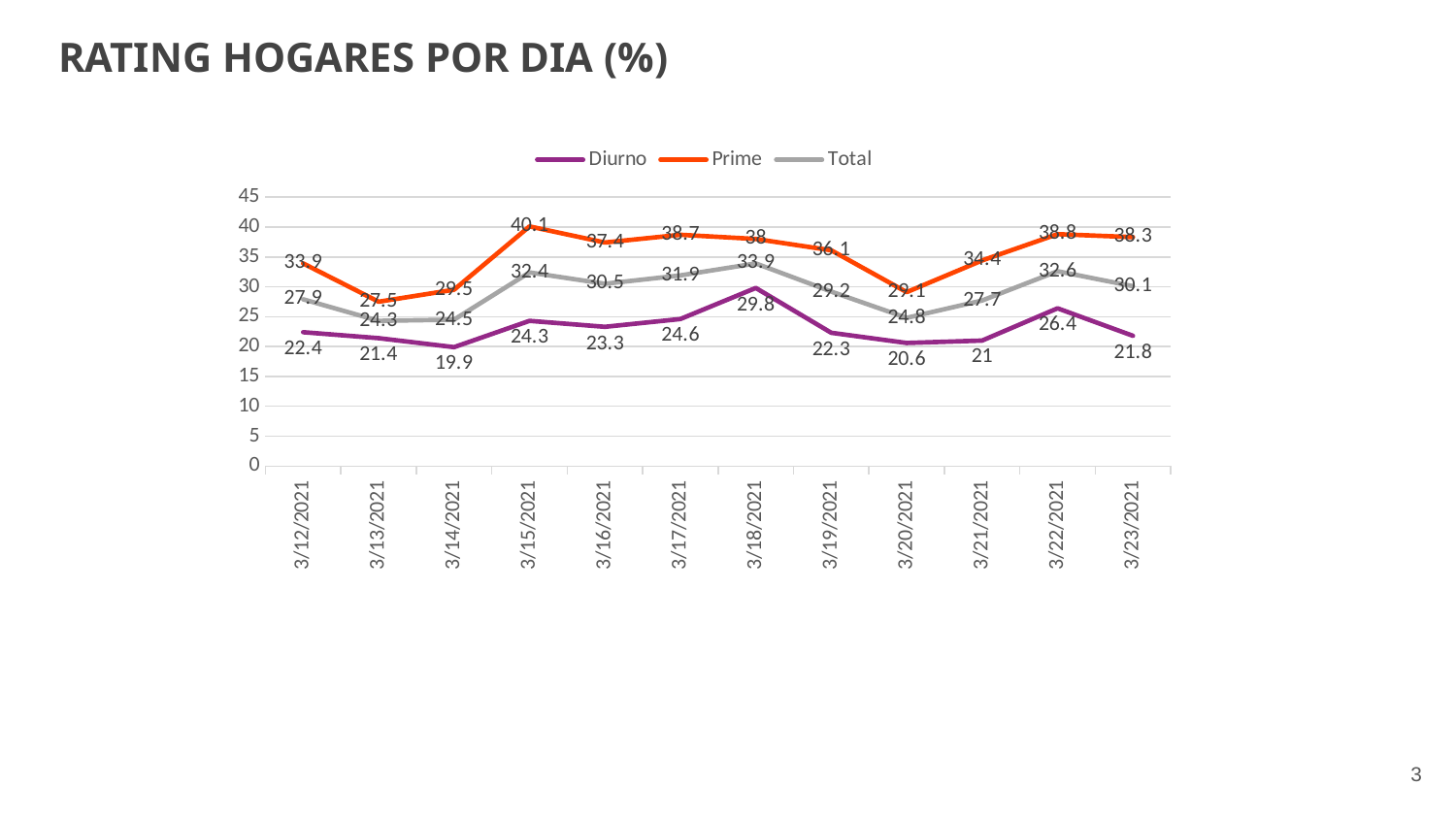
What type of chart is shown on the slide? line chart How many series does the legend list? 3 How many dates are plotted along the x axis? 12 Which is larger, the Prime value on 3/13/2021 or the Prime value on 3/14/2021? 3/14/2021 What is the difference between the Prime and Diurno values on 3/15/2021? 15.8 On which date is the Prime series highest? 3/15/2021 What is the Total value on 3/20/2021? 24.8 What is the Diurno value on 3/18/2021? 29.8 On which date is the Total series highest? 3/18/2021 Which series is drawn in orange? Prime On which date is the Diurno series lowest? 3/14/2021 What is the Prime value on 3/15/2021? 40.1